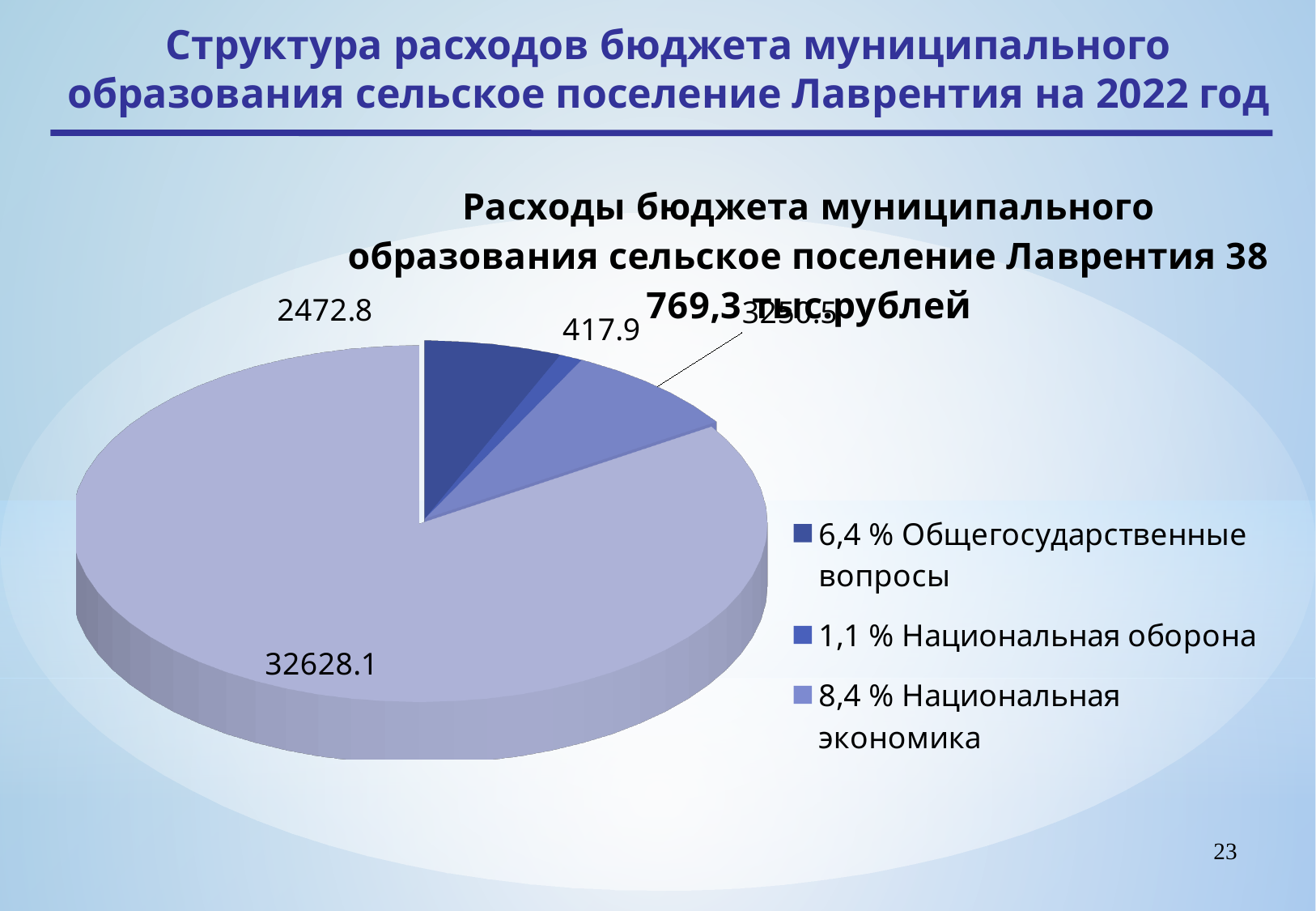
What is the difference between the values for Общегосударственные вопросы and Национальная оборона? 2054.9 What kind of chart is shown on the slide? Pie chart Which is larger: Общегосударственные вопросы or Национальная оборона? Общегосударственные вопросы What is the value shown for Национальная оборона? 417.9 How many entries does the legend list? 3 What is the value shown for Общегосударственные вопросы? 2472.8 How many slices does the pie chart have? 4 What share of the pie does Национальная экономика represent according to the legend? 8,4 % What share of the pie does Общегосударственные вопросы represent according to the legend? 6,4 % Which legend category has the smallest value? Национальная оборона What is the largest value printed on the pie chart? 32628.1 What total amount of budget expenditures is stated in the chart title? 38 769,3 тыс.рублей